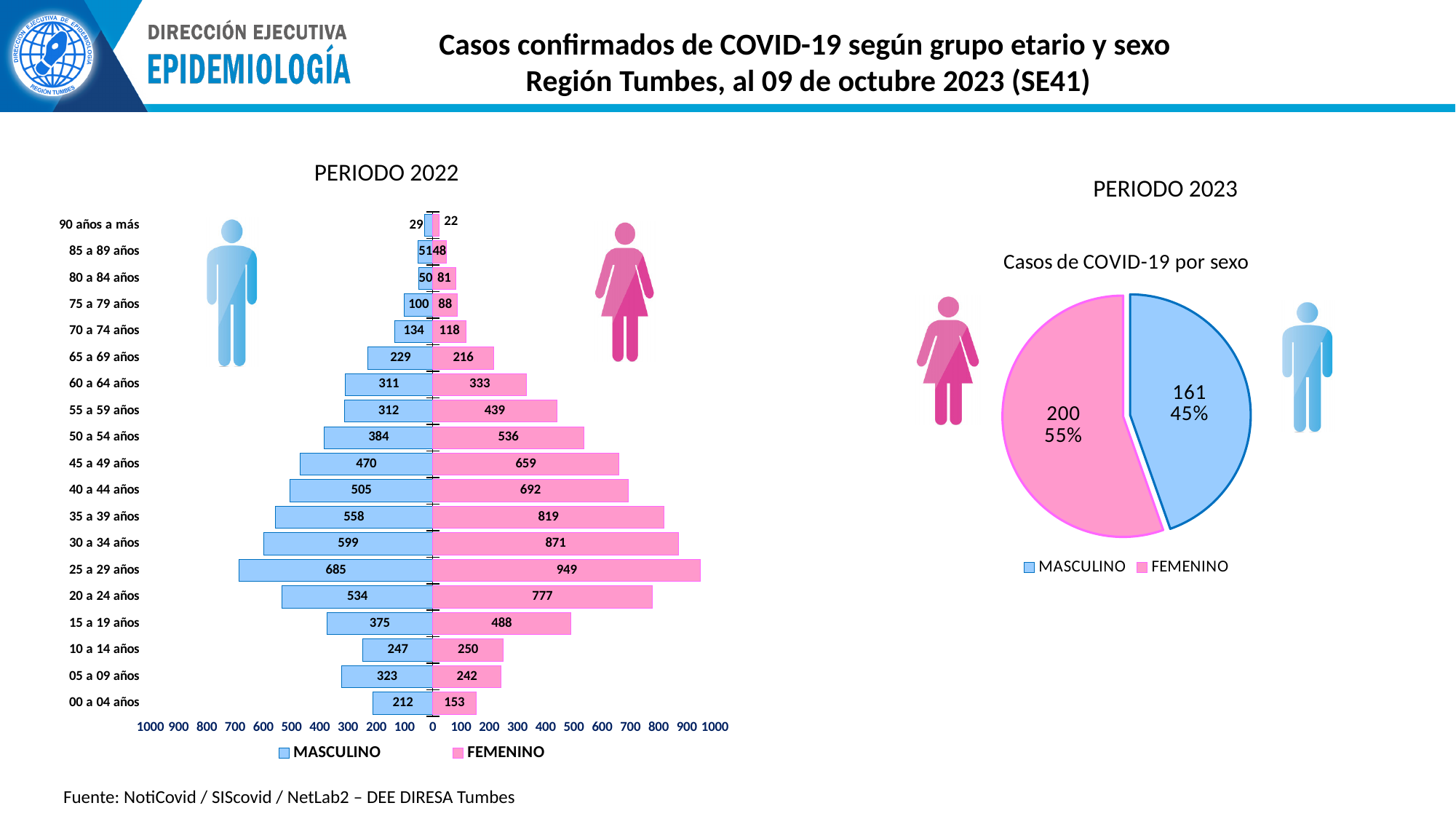
In the PERIODO 2022 chart, what is the MASCULINO value for 25 a 29 años? 685 In the PERIODO 2022 chart, how many age groups are shown? 19 In the PERIODO 2022 chart, which age group has the highest FEMENINO value? 25 a 29 años How many series does the legend of the PERIODO 2022 chart list? 2 In the PERIODO 2023 pie chart, what share of cases is FEMENINO? 55% In the PERIODO 2023 pie chart, what is the MASCULINO value? 161 In the PERIODO 2022 chart, for 05 a 09 años, which is larger, MASCULINO or FEMENINO? MASCULINO What is the title of the pie chart on the right of the slide? Casos de COVID-19 por sexo In the PERIODO 2022 chart, which age group has the lowest MASCULINO value? 90 años a más In the PERIODO 2022 chart, what is the FEMENINO value for 30 a 34 años? 871 In the PERIODO 2022 chart, what is the difference between the FEMENINO and MASCULINO values for 45 a 49 años? 189 What kind of chart is the PERIODO 2022 chart? Bar chart